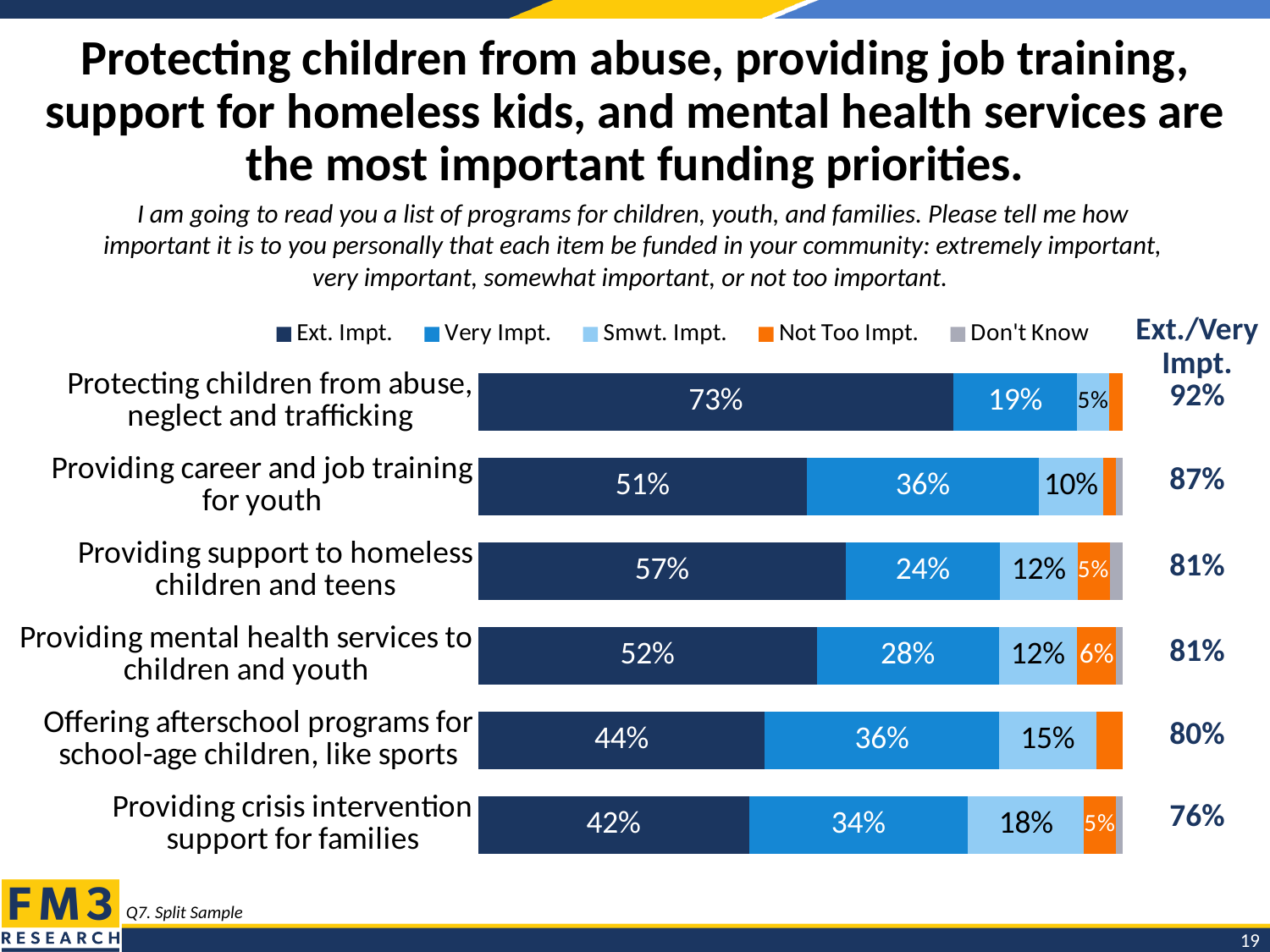
What is the Smwt. Impt. value for 'Providing crisis intervention support for families'? 18% How many percentage points higher is the Ext. Impt. value for 'Providing support to homeless children and teens' than for 'Providing mental health services to children and youth'? 5 percentage points What type of chart is shown on the slide? Stacked bar chart Which has a larger Very Impt. value: 'Offering afterschool programs for school-age children, like sports' or 'Providing support to homeless children and teens'? Offering afterschool programs for school-age children, like sports How many programs are listed in the chart? 6 What is the combined Ext./Very Impt. figure shown for 'Offering afterschool programs for school-age children, like sports'? 80% Which program has the highest Ext. Impt. percentage? Protecting children from abuse, neglect and trafficking What is the Very Impt. value for 'Providing career and job training for youth'? 36% What percentage rated 'Protecting children from abuse, neglect and trafficking' as extremely important (Ext. Impt.)? 73% Which program has the lowest Ext. Impt. percentage? Providing crisis intervention support for families What colour represents 'Not Too Impt.' in the legend? Orange How many response categories does the legend list? 5